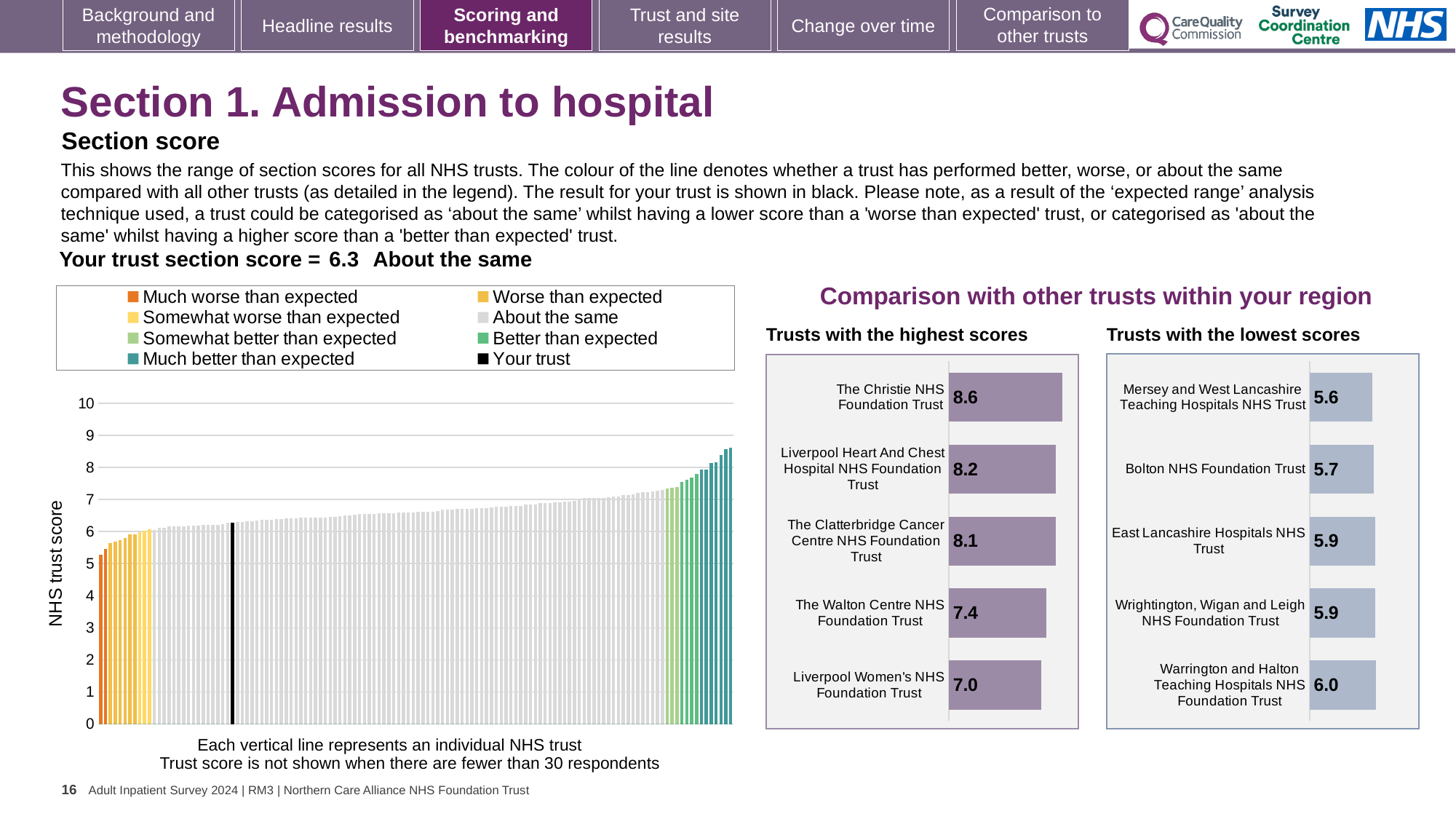
In the 'Trusts with the highest scores' chart, which has the higher score: The Walton Centre NHS Foundation Trust or The Clatterbridge Cancer Centre NHS Foundation Trust? The Clatterbridge Cancer Centre NHS Foundation Trust What kind of chart is the 'Trusts with the lowest scores' chart? Bar chart In the 'Trusts with the lowest scores' chart, what is the score for Warrington and Halton Teaching Hospitals NHS Foundation Trust? 6.0 In the 'Trusts with the lowest scores' chart, what is the score for Bolton NHS Foundation Trust? 5.7 In the 'Trusts with the lowest scores' chart, what is the difference between the scores of Bolton NHS Foundation Trust and Mersey and West Lancashire Teaching Hospitals NHS Trust? 0.1 How many trusts are shown in the 'Trusts with the highest scores' chart? 5 In the NHS trust score chart on the left, what is the section score for your trust (the black line)? 6.3 How many entries does the legend of the NHS trust score chart on the left list? 8 In the 'Trusts with the lowest scores' chart, which trust has the lowest score? Mersey and West Lancashire Teaching Hospitals NHS Trust In the 'Trusts with the highest scores' chart, what is the difference between the scores of The Christie NHS Foundation Trust and Liverpool Women's NHS Foundation Trust? 1.6 In the 'Trusts with the highest scores' chart, which trust has the highest score? The Christie NHS Foundation Trust In the 'Trusts with the highest scores' chart, what is the score for The Christie NHS Foundation Trust? 8.6